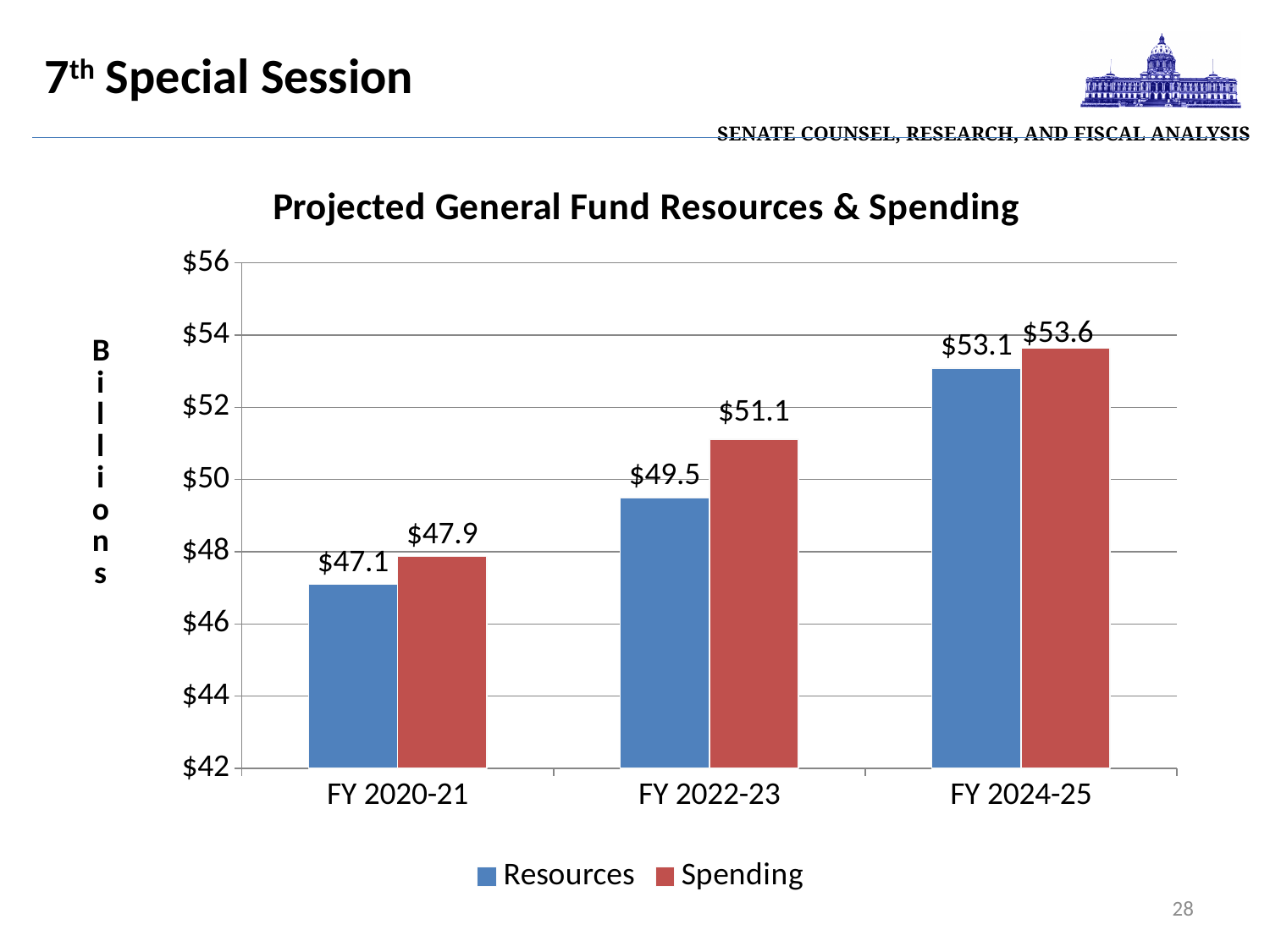
What is the difference between Spending and Resources for FY 2022-23? $1.6 What is the value of Resources for FY 2020-21? $47.1 Which fiscal year has the highest Resources value? FY 2024-25 How many series does the legend list? 2 Which is larger for FY 2024-25, Resources or Spending? Spending What is the value of Spending for FY 2024-25? $53.6 What is the value of Spending for FY 2022-23? $51.1 What kind of chart is shown on the slide? bar chart Which fiscal year has the lowest Spending value? FY 2020-21 Is the Resources value for FY 2022-23 greater or less than $50? less Do the Spending values rise or fall from FY 2020-21 to FY 2024-25? rise How many fiscal years are shown on the x axis? 3